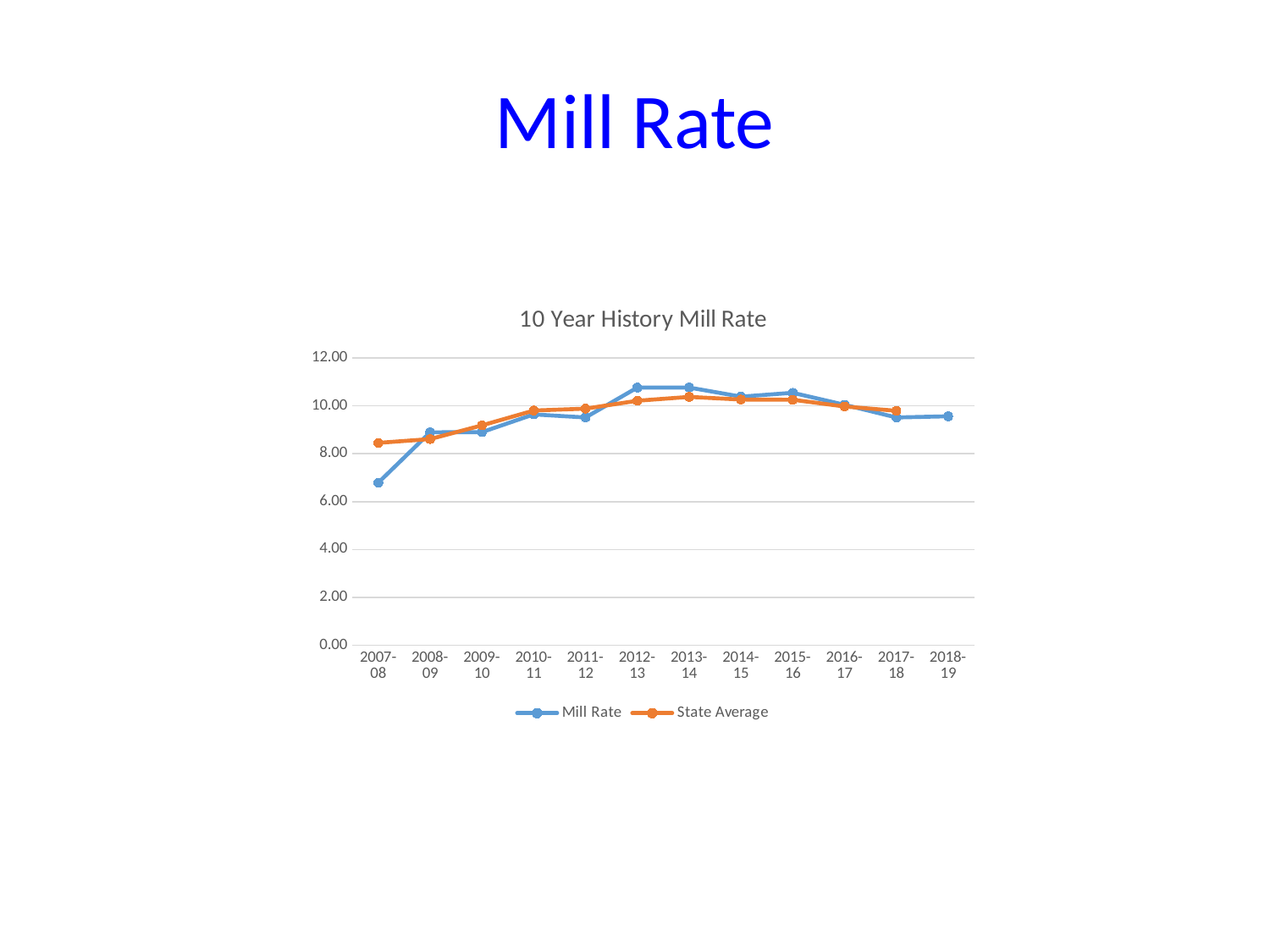
What kind of chart is shown on the slide? line chart How many school years are shown on the x axis? 12 Is the Mill Rate for 2018-19 greater or less than 10.00? less How many series does the legend list? 2 In which year is the Mill Rate lowest? 2007-08 What is the title of the chart? 10 Year History Mill Rate Is the Mill Rate for 2007-08 greater or less than 8.00? less Is the State Average for 2007-08 greater or less than 8.00? greater In 2012-13, which is larger, the Mill Rate or the State Average? Mill Rate Which series is drawn in orange? State Average In 2007-08, which is larger, the Mill Rate or the State Average? State Average